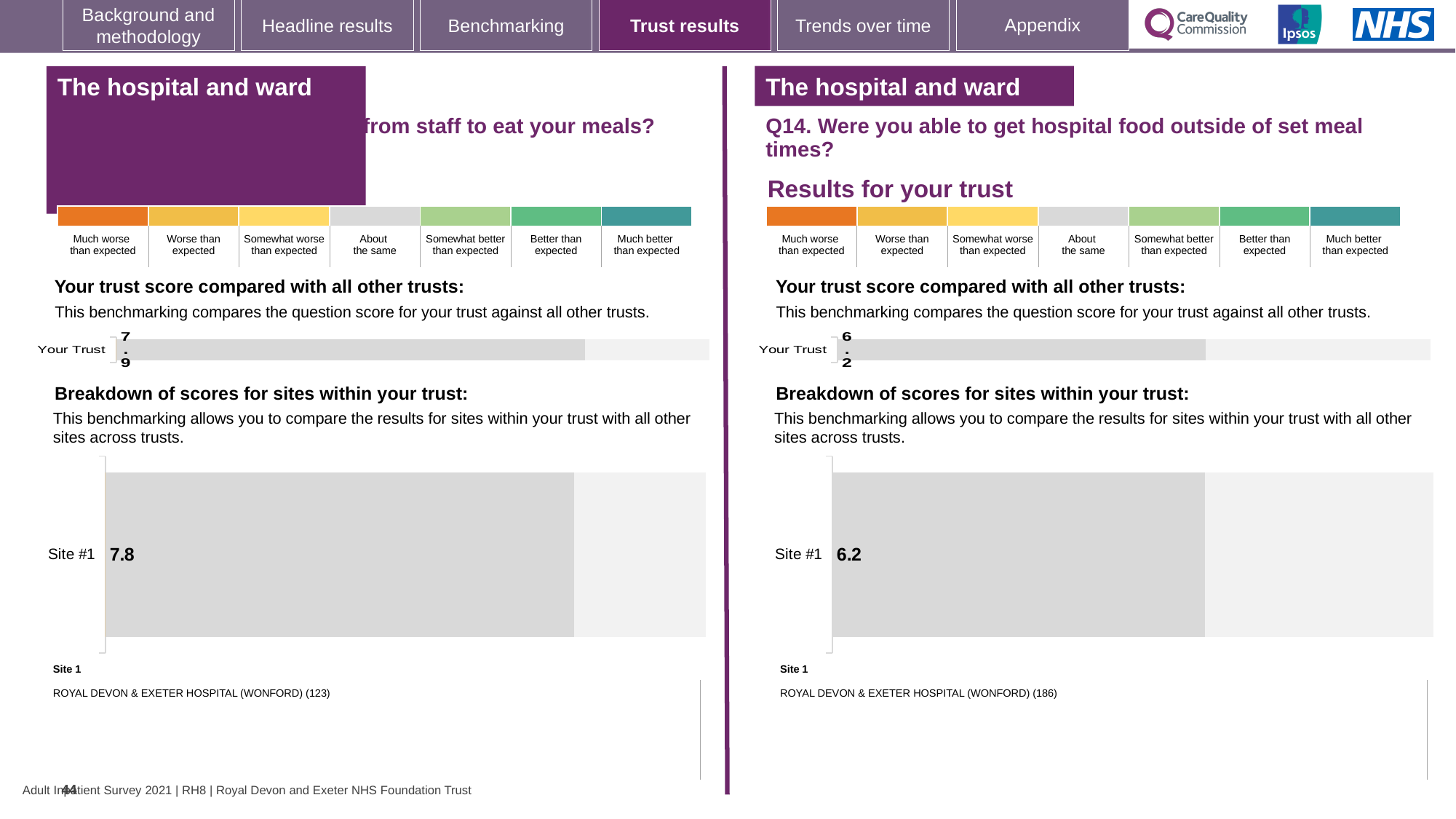
On the left-hand side of the slide, which is larger: the Your Trust score or the Site #1 score? Your Trust (7.9) What is the difference between the Your Trust score on the left-hand side (7.9) and the Your Trust score on the right-hand side (6.2)? 1.7 What kind of chart is used to show the Site #1 score on the right-hand side (Q14)? Bar chart On the right-hand side (Q14), what is the score shown for Your Trust in the 'Your trust score compared with all other trusts' chart? 6.2 Which is larger: the Site #1 score on the left-hand side of the slide or the Site #1 score on the right-hand side (Q14)? Left-hand side (7.8) On the right-hand side (Q14), what is the score shown for Site #1 in the 'Breakdown of scores for sites within your trust' chart? 6.2 How many sites are shown in the 'Breakdown of scores for sites within your trust' chart on the left-hand side of the slide? 1 How many sites are shown in the 'Breakdown of scores for sites within your trust' chart on the right-hand side (Q14)? 1 On the left-hand side of the slide, what is the score shown for Site #1 in the 'Breakdown of scores for sites within your trust' chart? 7.8 What is the difference between the Site #1 score on the left-hand side (7.8) and the Site #1 score on the right-hand side (6.2)? 1.6 Which site name is listed as Site 1 below the right-hand (Q14) breakdown chart? ROYAL DEVON & EXETER HOSPITAL (WONFORD) (186) On the left-hand side of the slide, what is the score shown for Your Trust in the 'Your trust score compared with all other trusts' chart? 7.9